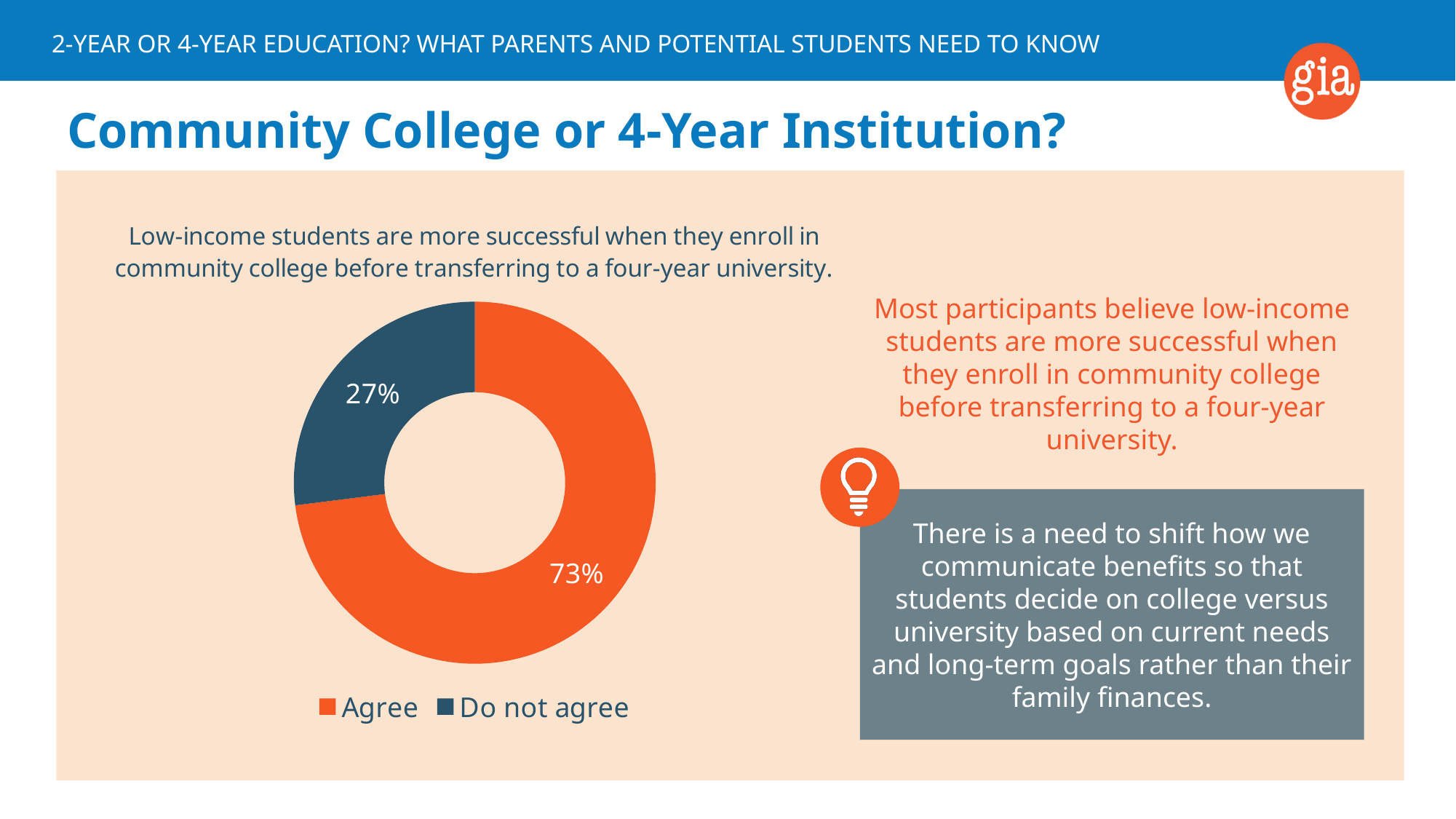
Which response has the larger share of the chart, Agree or Do not agree? Agree What colour is the Agree slice of the chart? Orange How many categories does the chart show? 2 What share of the chart does the Agree slice represent? 73% What percentage of participants do not agree with the statement in the chart? 27% What percentage of participants agree that low-income students are more successful when they enroll in community college before transferring to a four-year university? 73% Is the share for Do not agree greater or less than 50%? less Is the share for Agree larger or smaller than the share for Do not agree? larger Which response has the smallest share of the chart? Do not agree What are the two legend entries of the chart? Agree and Do not agree What kind of chart is shown on the slide? Doughnut (pie) chart What is the difference in percentage points between the Agree and Do not agree shares? 46